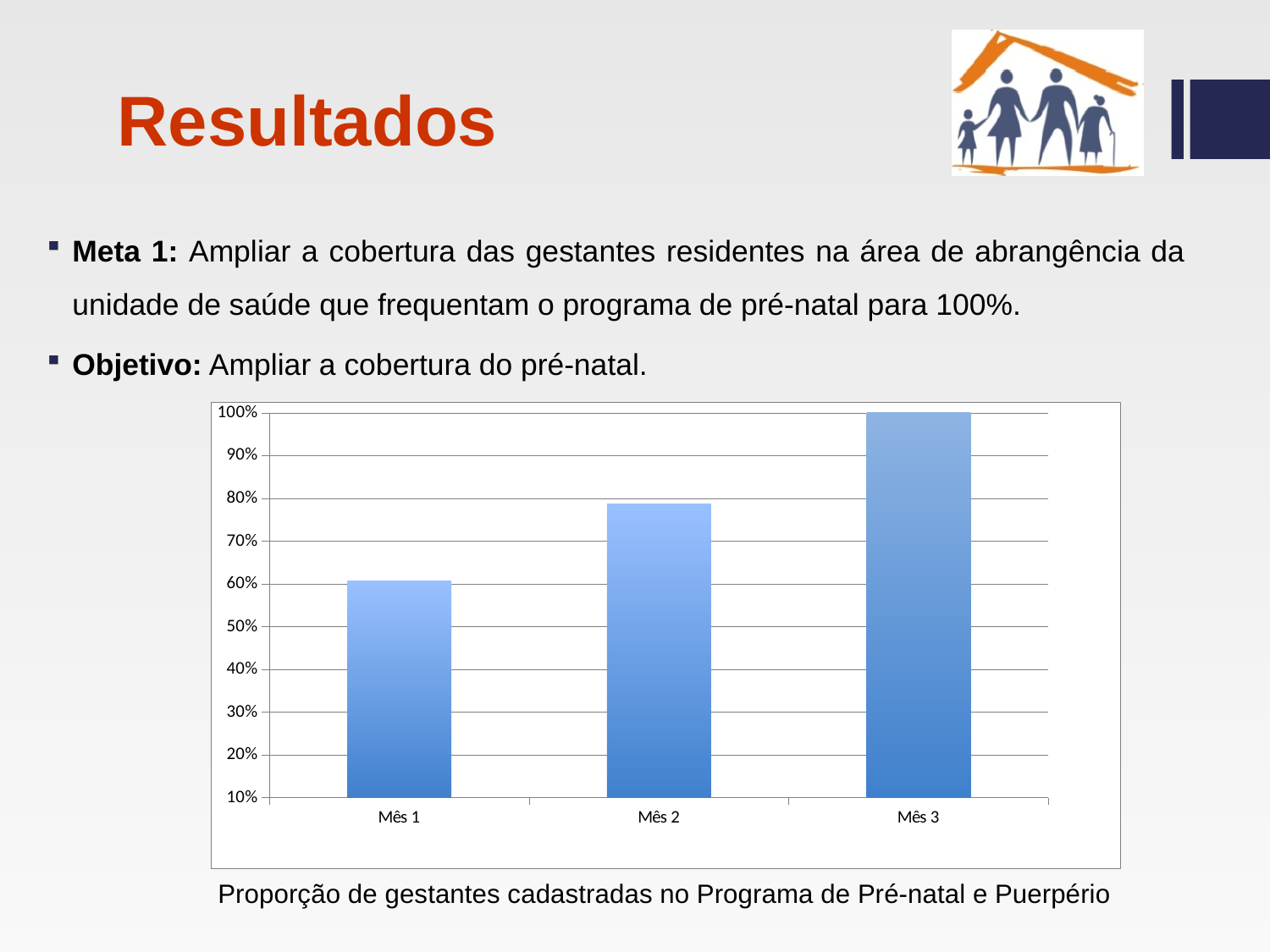
Which month has the highest bar on the chart? Mês 3 Is the value for Mês 1 greater or less than 50%? greater How many categories (months) are plotted on the chart? 3 Is the value for Mês 1 greater or less than 70%? less What is the value for Mês 3 on the chart? 100% Is the value for Mês 2 greater or less than 70%? greater What kind of chart is shown on the slide? bar chart Which is larger, the value for Mês 1 or the value for Mês 2? Mês 2 Which month has the lowest bar on the chart? Mês 1 What is the caption printed below the chart? Proporção de gestantes cadastradas no Programa de Pré-natal e Puerpério Do the values rise or fall from Mês 1 to Mês 3? rise